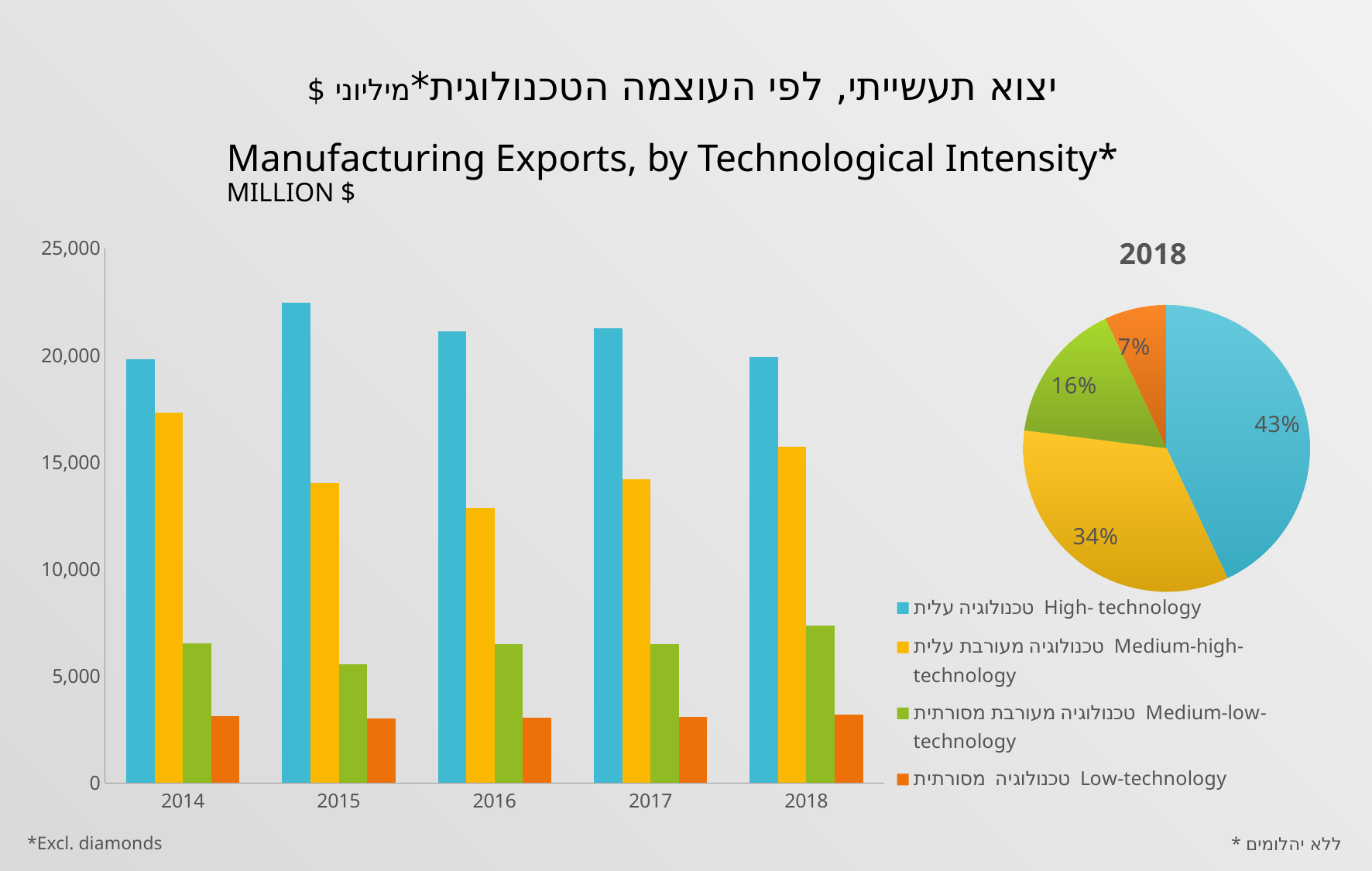
In the pie chart for 2018, what share does High-technology have? 43% In the bar chart, is the value for Medium-high-technology in 2016 greater or less than 15,000? less In the bar chart, how many years are shown on the x axis? 5 In the bar chart, is the value for High-technology in 2015 greater or less than 20,000? greater In the bar chart, in which year is the Medium-high-technology bar the lowest? 2016 In the bar chart, how many series does the legend list? 4 In the pie chart for 2018, what share does Low-technology have? 7% In the bar chart, in which year is the High-technology bar the tallest? 2015 In the pie chart for 2018, which category has the smallest slice? Low-technology In the pie chart for 2018, what share does Medium-high-technology have? 34% In the pie chart for 2018, which category has the largest slice? High-technology In the pie chart for 2018, how many percentage points larger is the High-technology share than the Medium-high-technology share? 9